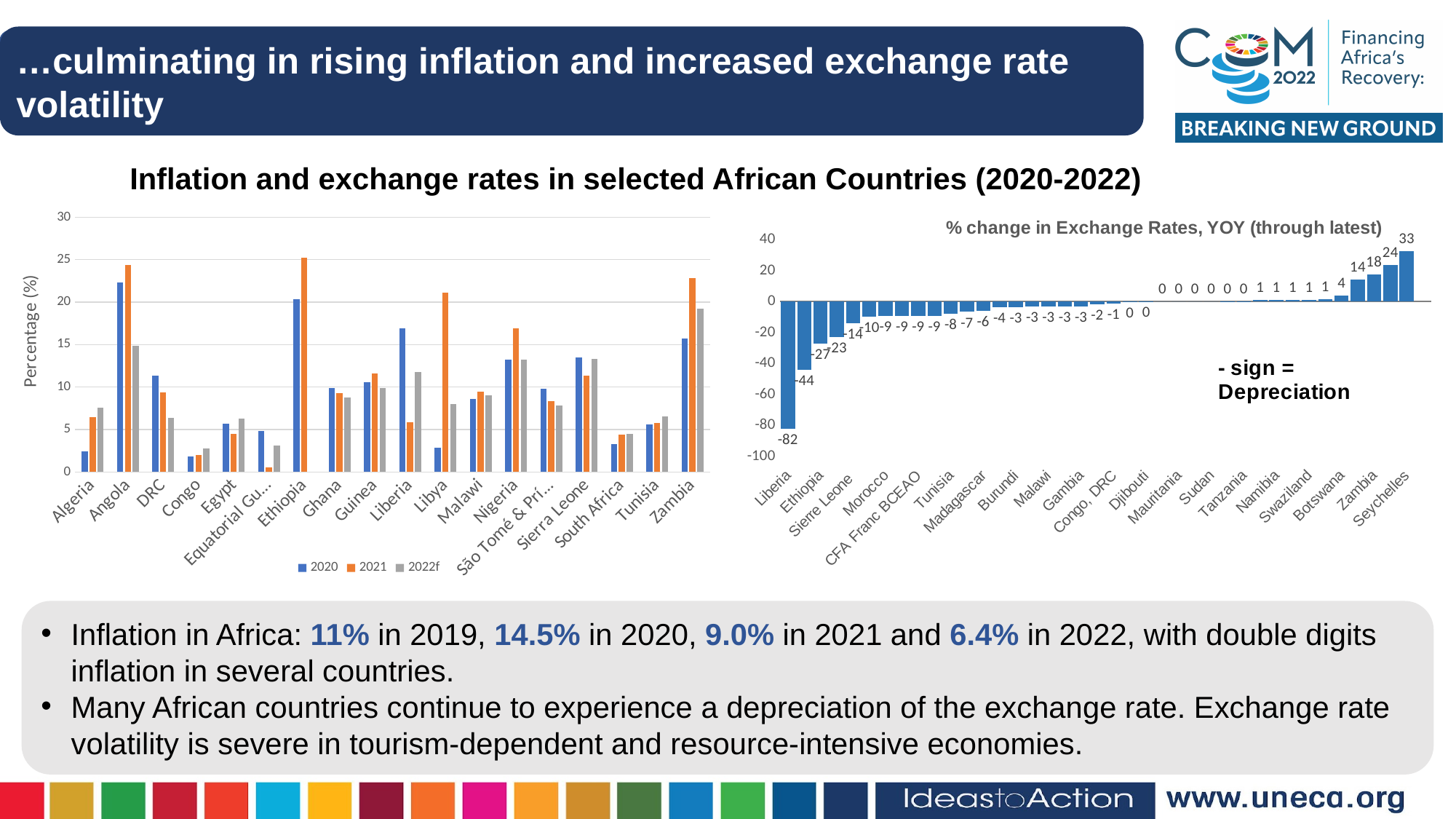
What is the title of the chart on the right? % change in Exchange Rates, YOY (through latest) In the exchange rate chart on the right, what is the difference between the values for Seychelles and Liberia? 115 What kind of chart is the inflation chart on the left? bar chart In the inflation chart on the left, is the 2020 value for Angola greater or less than 20? greater In the inflation chart on the left, which is larger for 2021: Angola or Algeria? Angola In the inflation chart on the left, is the 2020 value for Congo greater or less than 5? less In the exchange rate chart on the right, what is the % change in exchange rate for Seychelles? 33 In the inflation chart on the left, how many countries are shown on the x axis? 18 In the exchange rate chart on the right, which country has the lowest % change? Liberia In the exchange rate chart on the right, which country has the highest % change? Seychelles In the exchange rate chart on the right, what is the % change in exchange rate for Liberia? -82 In the inflation chart on the left, how many series does the legend list? 3